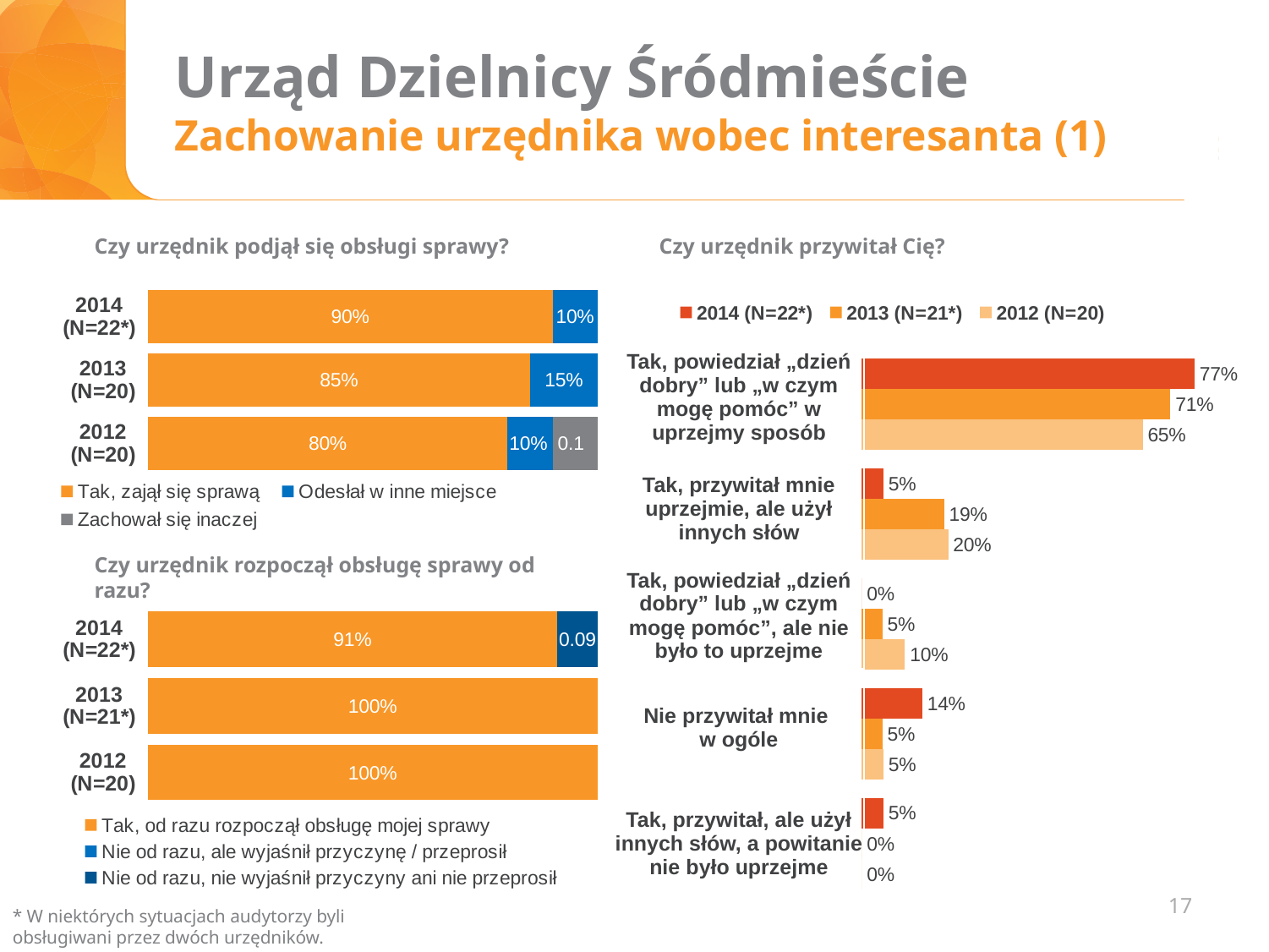
What kind of chart is "Czy urzędnik przywitał Cię?"? bar chart In the chart "Czy urzędnik przywitał Cię?", how many categories are shown? 5 In the chart "Czy urzędnik podjął się obsługi sprawy?", how many series does the legend list? 3 In the chart "Czy urzędnik podjął się obsługi sprawy?", what is the value for "Odesłał w inne miejsce" in 2013 (N=20)? 15% In the chart "Czy urzędnik rozpoczął obsługę sprawy od razu?", what is the value for "Tak, od razu rozpoczął obsługę mojej sprawy" in 2013 (N=21*)? 100% In the chart "Czy urzędnik przywitał Cię?", which is larger for "Tak, przywitał mnie uprzejmie, ale użył innych słów": the 2013 (N=21*) value or the 2014 (N=22*) value? 2013 (N=21*) In the chart "Czy urzędnik przywitał Cię?", what is the value for 2012 (N=20) in the category "Tak, przywitał mnie uprzejmie, ale użył innych słów"? 20% In the chart "Czy urzędnik podjął się obsługi sprawy?", what is the value for "Tak, zajął się sprawą" in 2014 (N=22*)? 90% In the chart "Czy urzędnik przywitał Cię?", what is the value for 2014 (N=22*) in the category "Nie przywitał mnie w ogóle"? 14% In the chart "Czy urzędnik przywitał Cię?", what is the difference between the 2014 (N=22*) and 2012 (N=20) values for "Tak, powiedział „dzień dobry” lub „w czym mogę pomóc” w uprzejmy sposób"? 12% In the chart "Czy urzędnik rozpoczął obsługę sprawy od razu?", what is the value for "Tak, od razu rozpoczął obsługę mojej sprawy" in 2014 (N=22*)? 91% In the chart "Czy urzędnik podjął się obsługi sprawy?", which year has the highest value for "Tak, zajął się sprawą"? 2014 (N=22*)